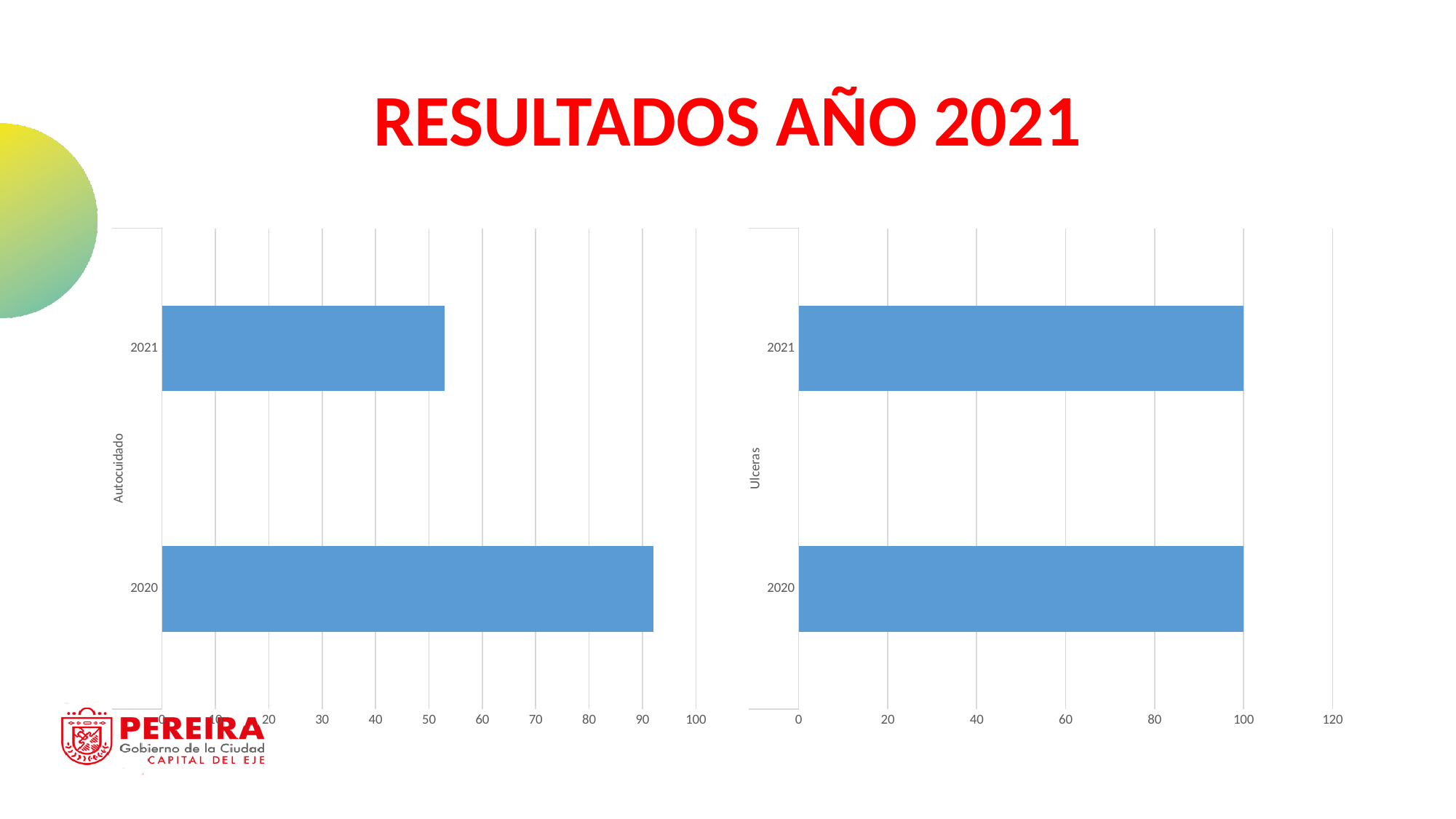
In the left chart (Autocuidado), which year has the highest value? 2020 In the right chart (Ulceras), what is the difference between the values for 2020 and 2021? 0 In the right chart (Ulceras), what is the value for 2021? 100 In the left chart (Autocuidado), which is larger, the value for 2020 or the value for 2021? 2020 In the right chart (Ulceras), what is the value for 2020? 100 What kind of chart is the left chart (Autocuidado)? bar chart What is the vertical axis label of the right chart? Ulceras What is the title of the slide? RESULTADOS AÑO 2021 In the left chart (Autocuidado), is the value for 2021 greater or less than 60? less In the left chart (Autocuidado), is the value for 2020 greater or less than 80? greater How many categories (years) are shown in the left chart (Autocuidado)? 2 In the left chart (Autocuidado), which year has the lowest value? 2021